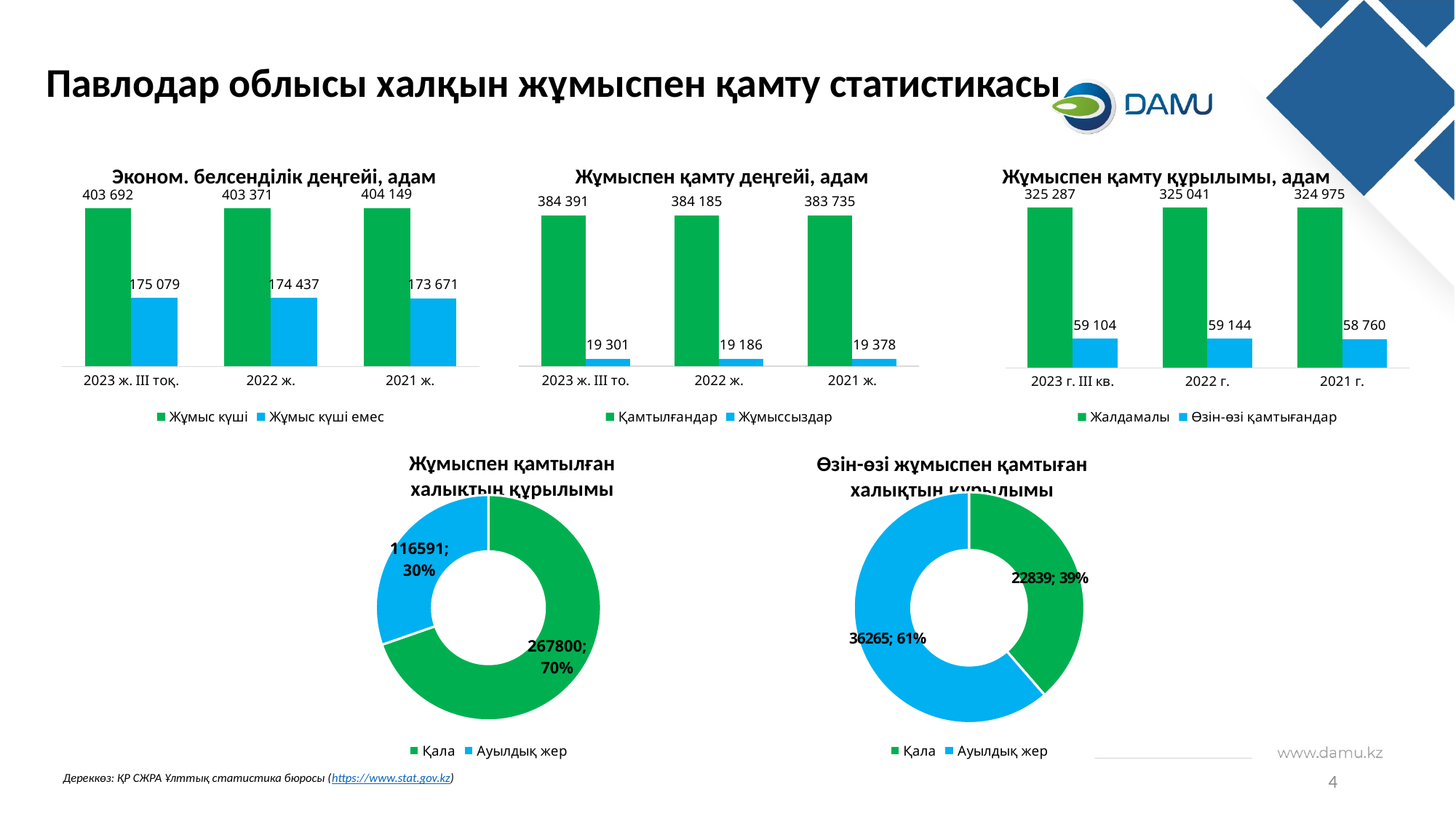
In the chart titled "Өзін-өзі жұмыспен қамтыған халықтың құрылымы", what is the value for Қала? 22839 What kind of chart is "Жұмыспен қамту деңгейі, адам"? Bar chart In the chart titled "Жұмыспен қамту құрылымы, адам", which period has the highest value of Жалдамалы? 2023 г. III кв. In the chart titled "Жұмыспен қамтылған халықтың құрылымы", what is the value for Қала? 267800 In the chart titled "Өзін-өзі жұмыспен қамтыған халықтың құрылымы", which category is larger, Қала or Ауылдық жер? Ауылдық жер In the chart titled "Жұмыспен қамту құрылымы, адам", what is the value of Өзін-өзі қамтығандар for 2021 г.? 58 760 In the chart titled "Жұмыспен қамту құрылымы, адам", how many series does the legend list? 2 In the chart titled "Эконом. белсенділік деңгейі, адам", what is the value of Жұмыс күші емес for 2023 ж. III тоқ.? 175 079 In the chart titled "Эконом. белсенділік деңгейі, адам", what is the value of Жұмыс күші for 2021 ж.? 404 149 In the chart titled "Жұмыспен қамту деңгейі, адам", what is the value of Жұмыссыздар for 2022 ж.? 19 186 In the chart titled "Жұмыспен қамтылған халықтың құрылымы", what share does Ауылдық жер have? 30% In the chart titled "Жұмыспен қамту деңгейі, адам", what is the difference between Қамтылғандар for 2023 ж. III то. and for 2021 ж.? 656